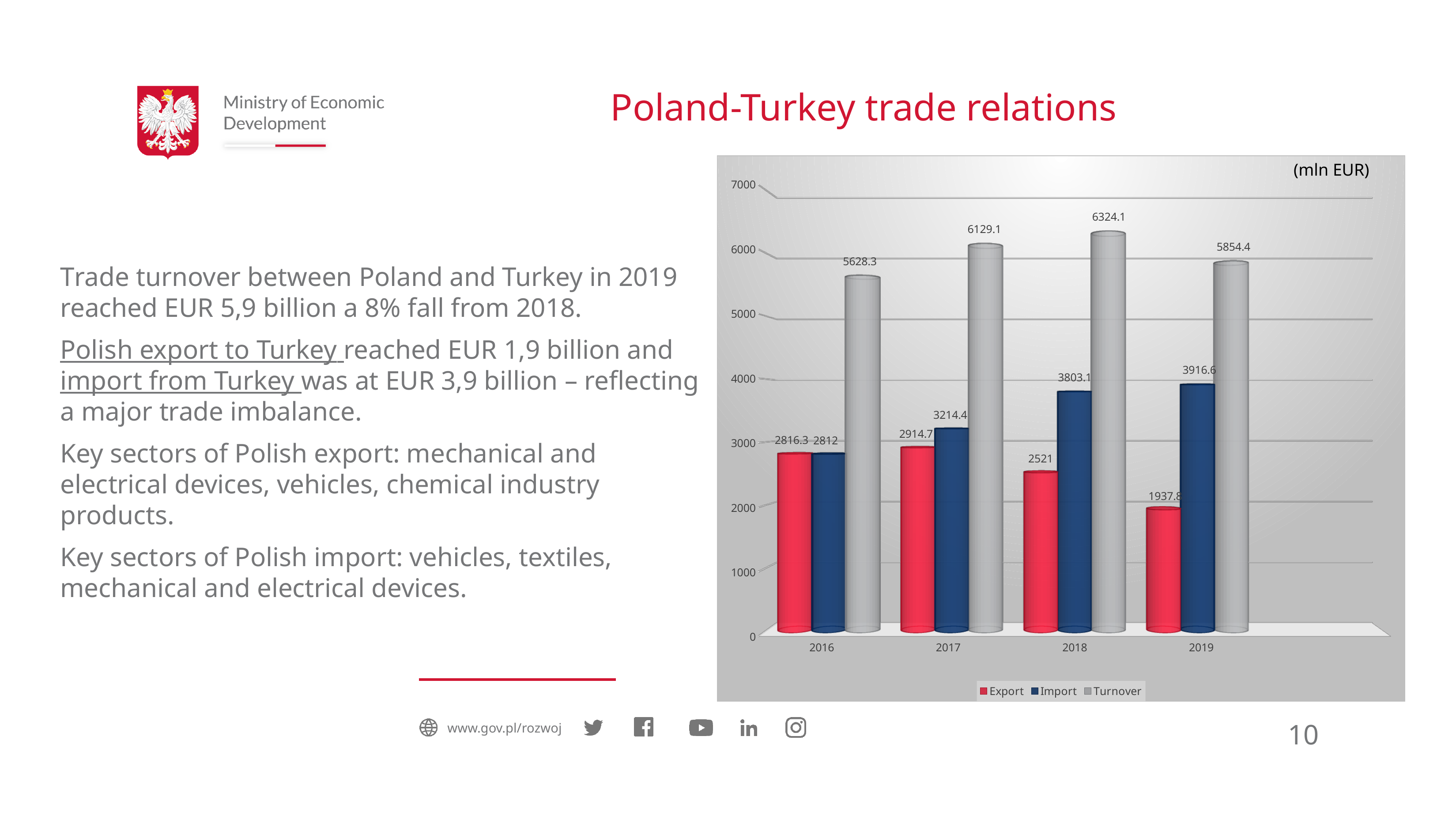
How many years are shown on the x axis? 4 What was the Import value in 2018? 3803.1 What was the Export value in 2019? 1937.8 What was the Turnover value in 2016? 5628.3 In which year was Export lowest? 2019 What kind of chart is shown on the slide? Bar chart How many series does the legend list? 3 What is the difference between Turnover in 2018 and Turnover in 2017? 195 Which was larger in 2018, Export or Import? Import In which year was Turnover highest? 2018 What is the difference between Import and Export in 2019? 1978.8 Is the Import value for 2017 greater or less than 3000? greater